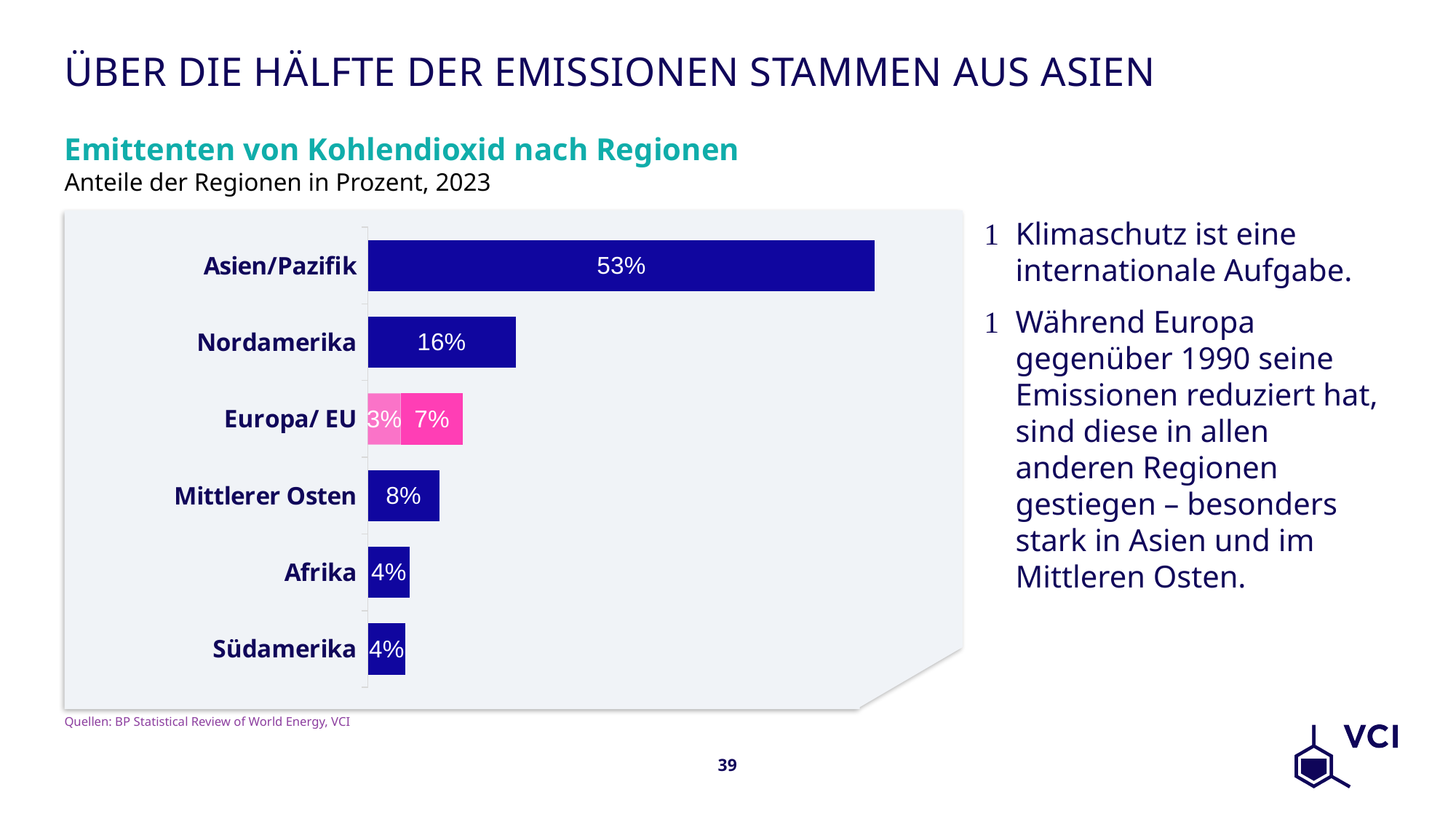
What is the value for Mittlerer Osten? 8% What is the difference between the values for Nordamerika and Mittlerer Osten? 8 percentage points What is the title of the chart? Emittenten von Kohlendioxid nach Regionen What is the difference between the values for Asien/Pazifik and Nordamerika? 37 percentage points Which region has the highest share? Asien/Pazifik What is the total of the two segments of the Europa/ EU bar? 10% What is the value for Nordamerika? 16% Which is larger, the value for Mittlerer Osten or the value for Afrika? Mittlerer Osten How many regions are shown in the chart? 6 What is the value for Afrika? 4% What is the value for Asien/Pazifik? 53% What kind of chart is shown on the slide? Bar chart